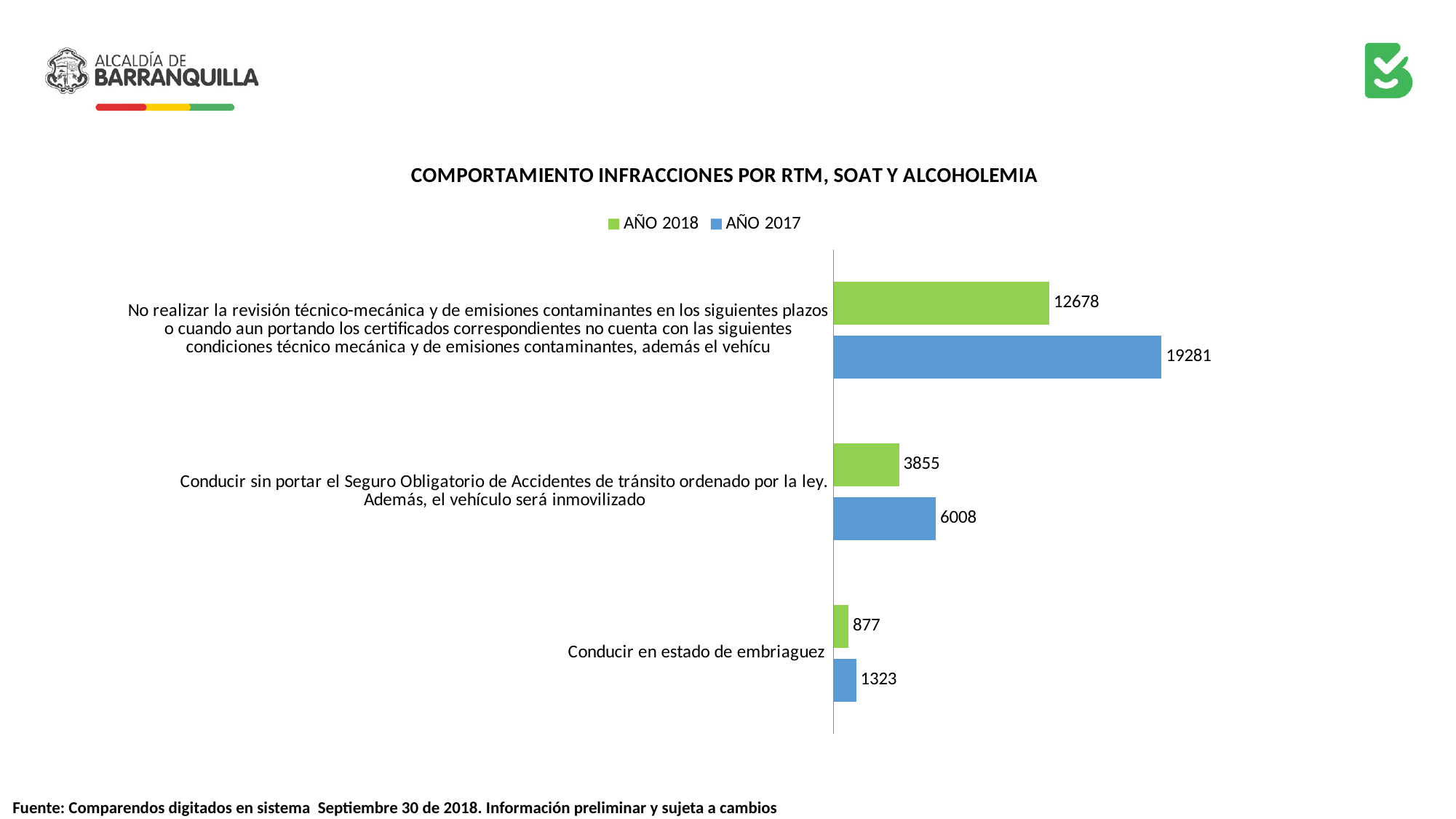
What is the AÑO 2017 value for the category about not performing the technical-mechanical review ('No realizar la revisión técnico-mecánica...')? 19281 What type of chart is shown on the slide? Bar chart What is the value for AÑO 2017 for 'Conducir en estado de embriaguez'? 1323 Which category has the highest AÑO 2018 value? No realizar la revisión técnico-mecánica y de emisiones contaminantes... How many categories are shown in the chart? 3 For 'Conducir en estado de embriaguez', which year has the larger value, AÑO 2018 or AÑO 2017? AÑO 2017 What is the difference between the AÑO 2017 and AÑO 2018 values for 'Conducir sin portar el Seguro Obligatorio de Accidentes de tránsito ordenado por la ley'? 2153 What is the value for AÑO 2017 for 'Conducir sin portar el Seguro Obligatorio de Accidentes de tránsito ordenado por la ley'? 6008 What is the value for AÑO 2018 for 'Conducir en estado de embriaguez'? 877 How many series does the legend list? 2 What is the value for AÑO 2018 for 'Conducir sin portar el Seguro Obligatorio de Accidentes de tránsito ordenado por la ley'? 3855 Which category has the lowest AÑO 2017 value? Conducir en estado de embriaguez